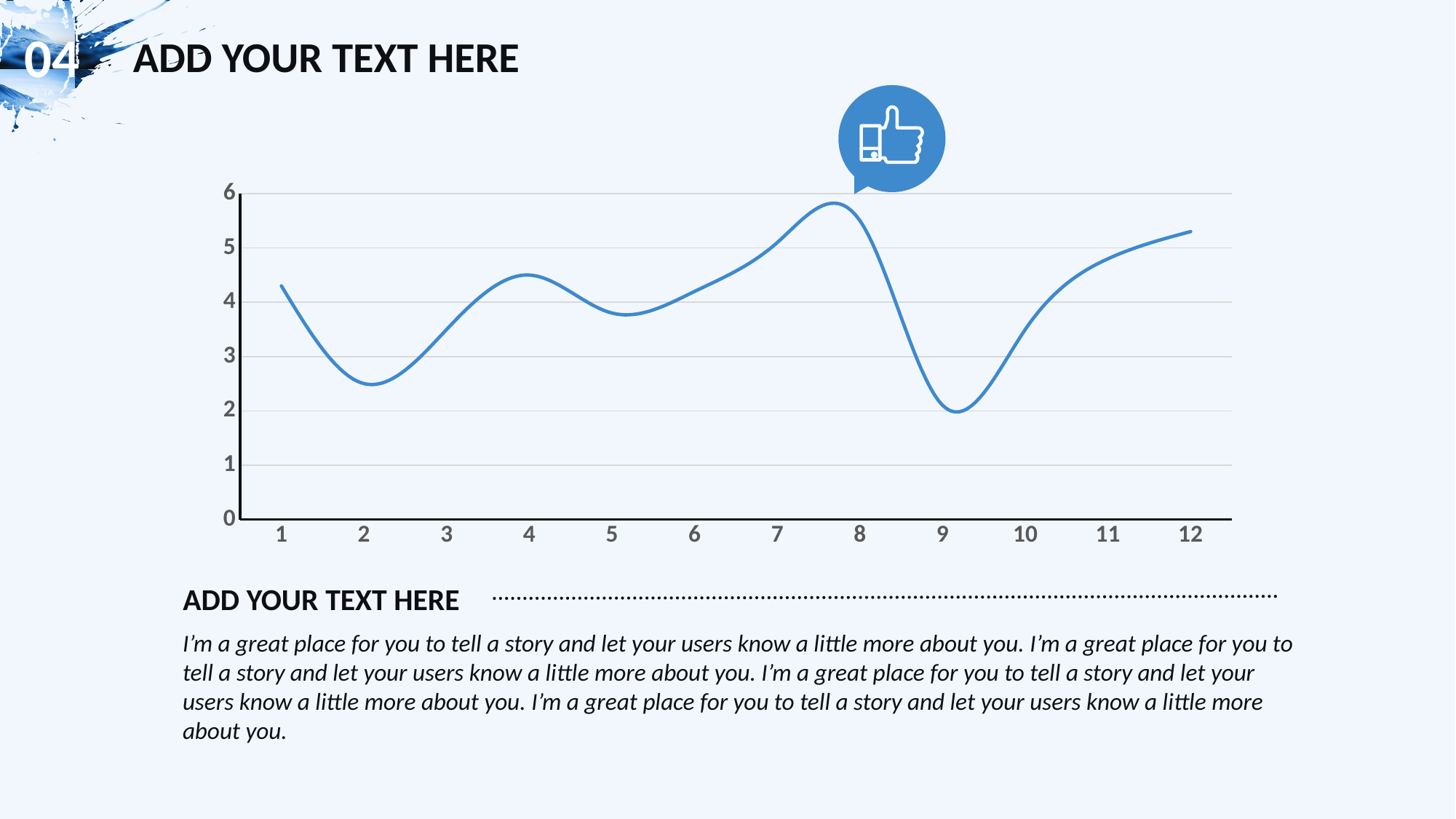
Is the value at x = 9 greater or less than 3? less Is the value at x = 2 greater or less than 3? less Which x-axis category has the highest value on the line chart? 8 Is the value at x = 12 greater or less than 5? greater Which has the larger value, x = 8 or x = 9? 8 Which has the larger value, x = 1 or x = 2? 1 What kind of chart is shown on the slide? line chart How many points are plotted along the x axis of the line chart? 12 Does the line rise or fall between x = 9 and x = 12? rise What is the highest value shown on the y axis of the line chart? 6